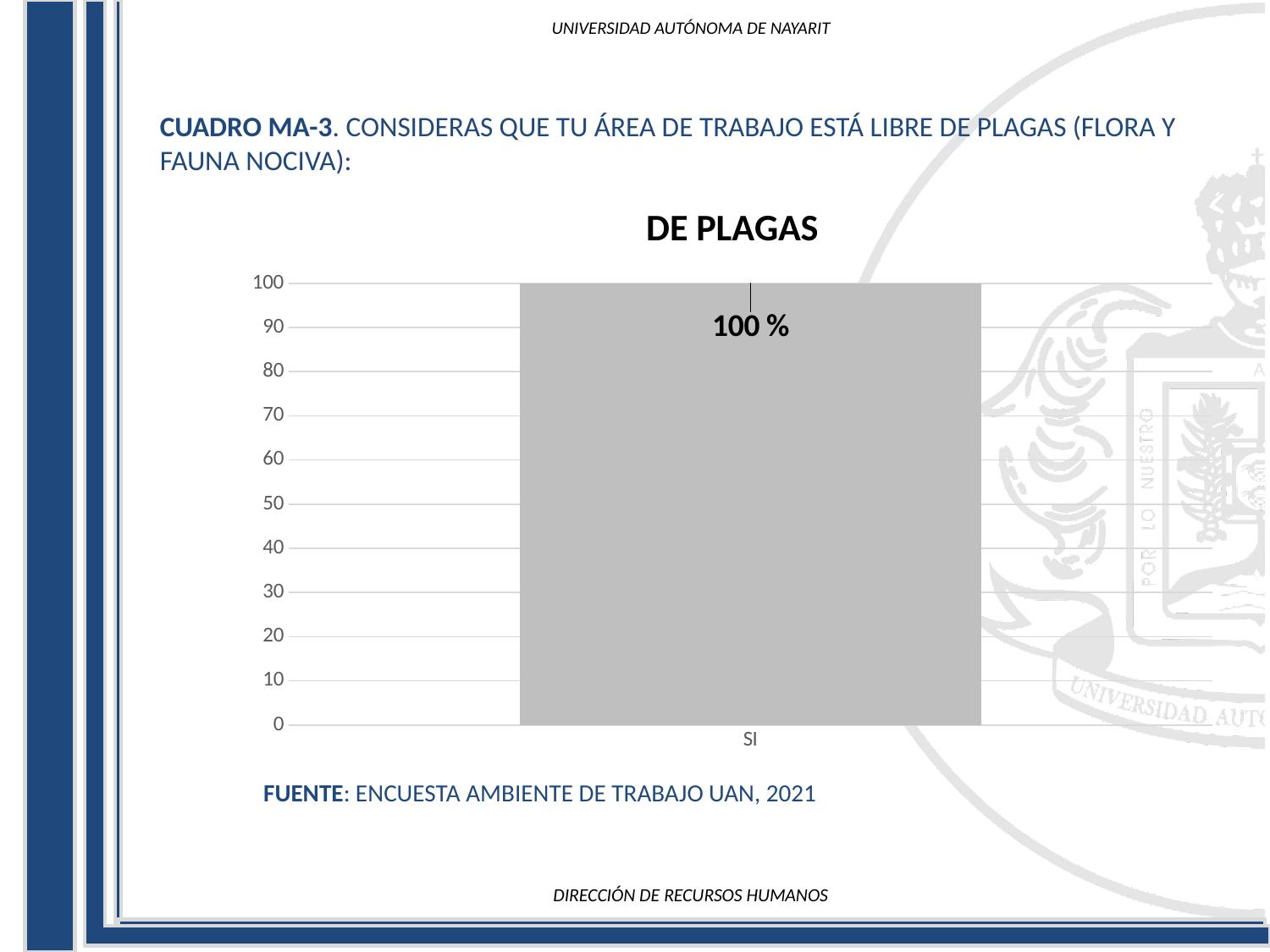
How many categories are plotted on the x axis? 1 Which category has the highest value? SI What kind of chart is shown on the slide? bar chart What is the highest value shown on the y axis? 100 What is the value for SI? 100 % Is the value for SI greater or less than 50? greater What is the label of the only category on the x axis? SI What is the title of the chart? DE PLAGAS